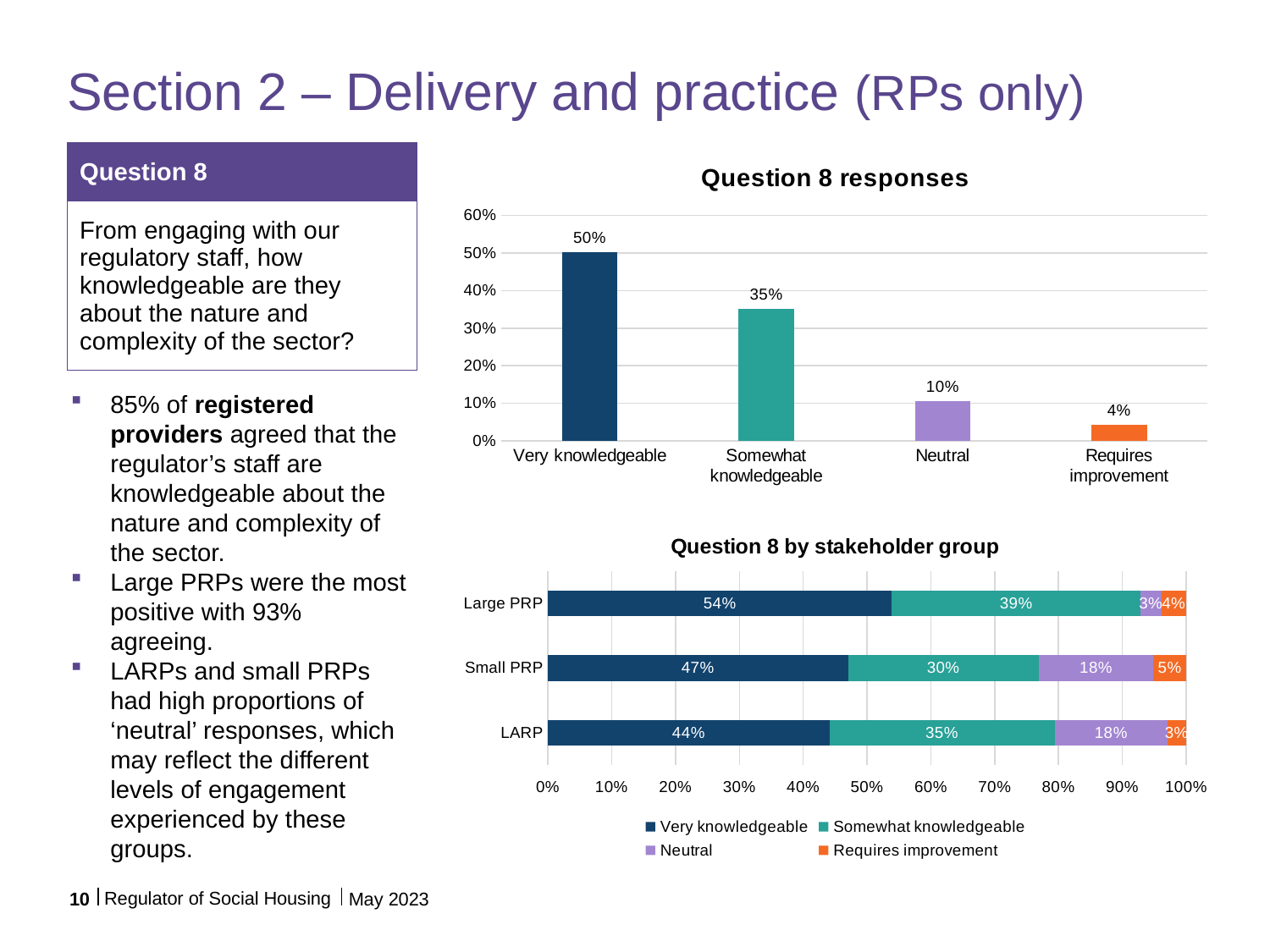
In the 'Question 8 by stakeholder group' chart, is the 'Somewhat knowledgeable' value larger for Large PRP or Small PRP? Large PRP In the 'Question 8 responses' chart, do the values rise or fall from left to right along the x axis? fall What kind of chart is 'Question 8 by stakeholder group'? stacked bar chart In the 'Question 8 by stakeholder group' chart, what colour represents 'Requires improvement'? orange In the 'Question 8 responses' chart, how many categories are shown on the x axis? 4 In the 'Question 8 responses' chart, what percentage of respondents answered 'Very knowledgeable'? 50% In the 'Question 8 by stakeholder group' chart, what is the 'Very knowledgeable' value for Small PRP? 47% In the 'Question 8 by stakeholder group' chart, what is the 'Neutral' value for LARP? 18% In the 'Question 8 by stakeholder group' chart, which stakeholder group has the highest 'Very knowledgeable' value? Large PRP How many series does the legend of the 'Question 8 by stakeholder group' chart list? 4 In the 'Question 8 responses' chart, which category has the lowest value? Requires improvement In the 'Question 8 responses' chart, what is the difference between the 'Very knowledgeable' and 'Somewhat knowledgeable' values? 15%